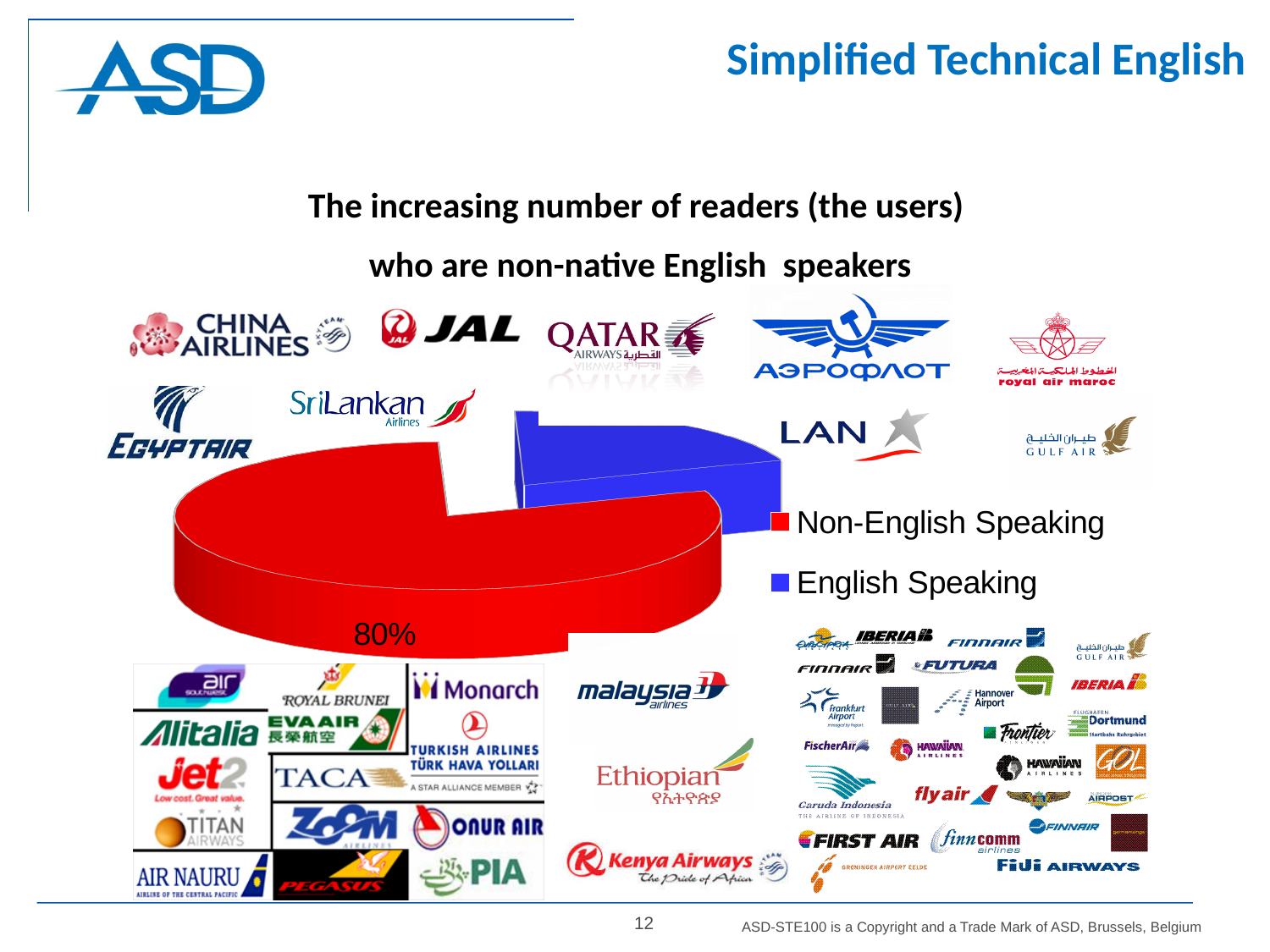
What colour represents English Speaking in the pie chart? blue What colour represents Non-English Speaking in the pie chart? red Which category has the largest slice of the pie chart? Non-English Speaking Is the Non-English Speaking share of the pie greater or less than 50%? greater How many slices does the pie chart have? 2 Is the English Speaking share of the pie greater or less than 50%? less What value is printed on the red slice of the pie chart? 80% What share of the pie is labelled for Non-English Speaking readers? 80% What kind of chart is shown on the slide? pie chart How many entries does the legend of the pie chart list? 2 Which slice is larger, Non-English Speaking or English Speaking? Non-English Speaking Which category has the smallest slice of the pie chart? English Speaking